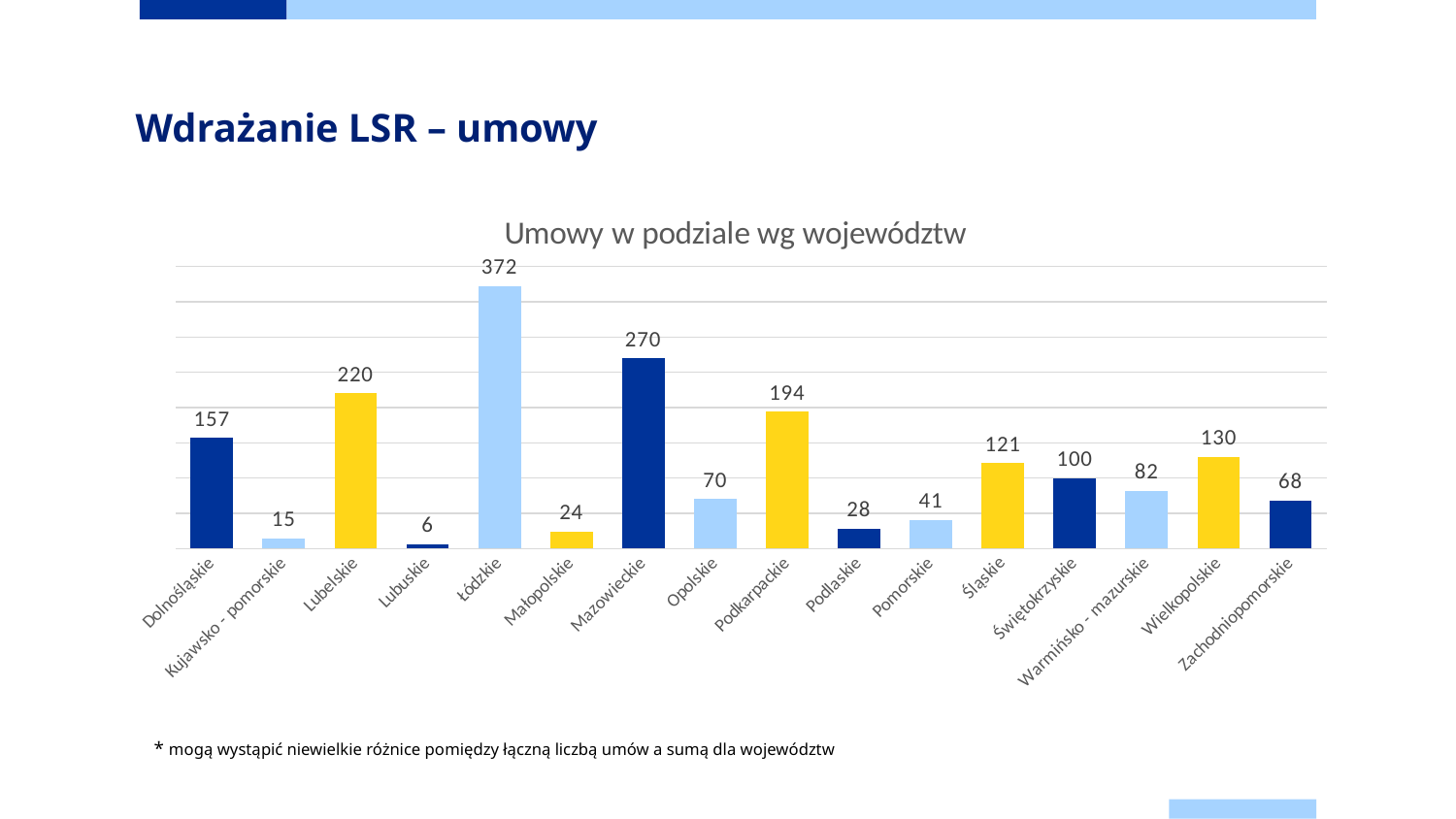
Which voivodeship has the highest value? Łódzkie What is the title of the chart? Umowy w podziale wg województw What is the value for Łódzkie? 372 What is the difference between the values for Mazowieckie and Lubelskie? 50 Which is larger, the value for Śląskie or the value for Wielkopolskie? Wielkopolskie What kind of chart is shown? bar chart What is the value for Podkarpackie? 194 Which voivodeship has the lowest value? Lubuskie How many voivodeships are shown on the x axis? 16 What is the value for Świętokrzyskie? 100 What is the value for Warmińsko - mazurskie? 82 What is the difference between the values for Dolnośląskie and Kujawsko - pomorskie? 142